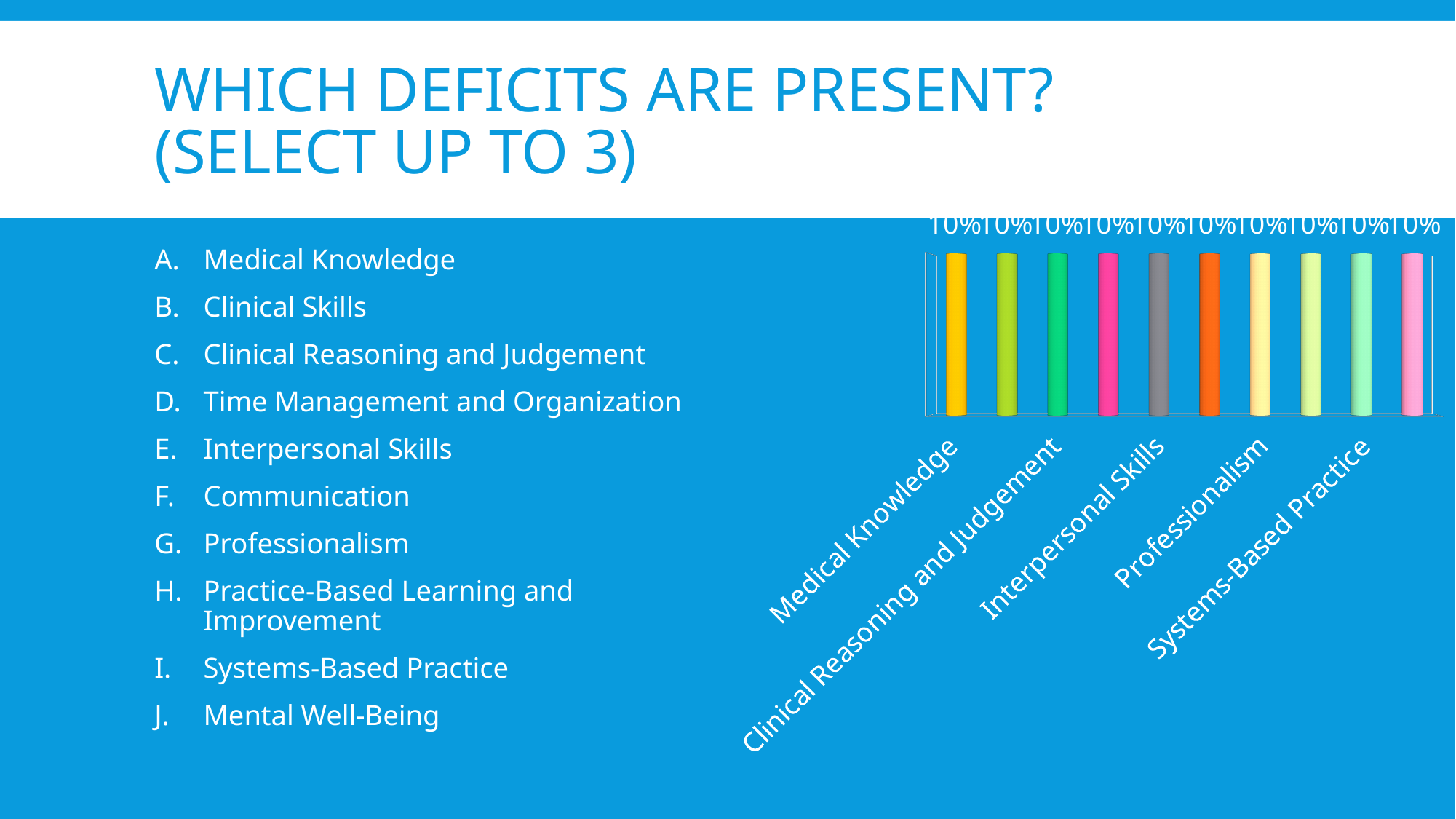
What is the difference between the values for Medical Knowledge and Professionalism? 0% How many bars are plotted in the chart? 10 Which category label appears first on the left of the x axis? Medical Knowledge What value is shown for Medical Knowledge? 10% What colour is the bar for Medical Knowledge, the first bar on the left? yellow-orange What value is shown for Professionalism? 10% Are the values for Clinical Reasoning and Judgement and Systems-Based Practice the same or different? the same What value is shown for Interpersonal Skills? 10% What kind of chart is shown on the slide? bar chart What value is shown for Systems-Based Practice? 10% Do the values rise, fall, or stay flat across the categories from left to right? stay flat